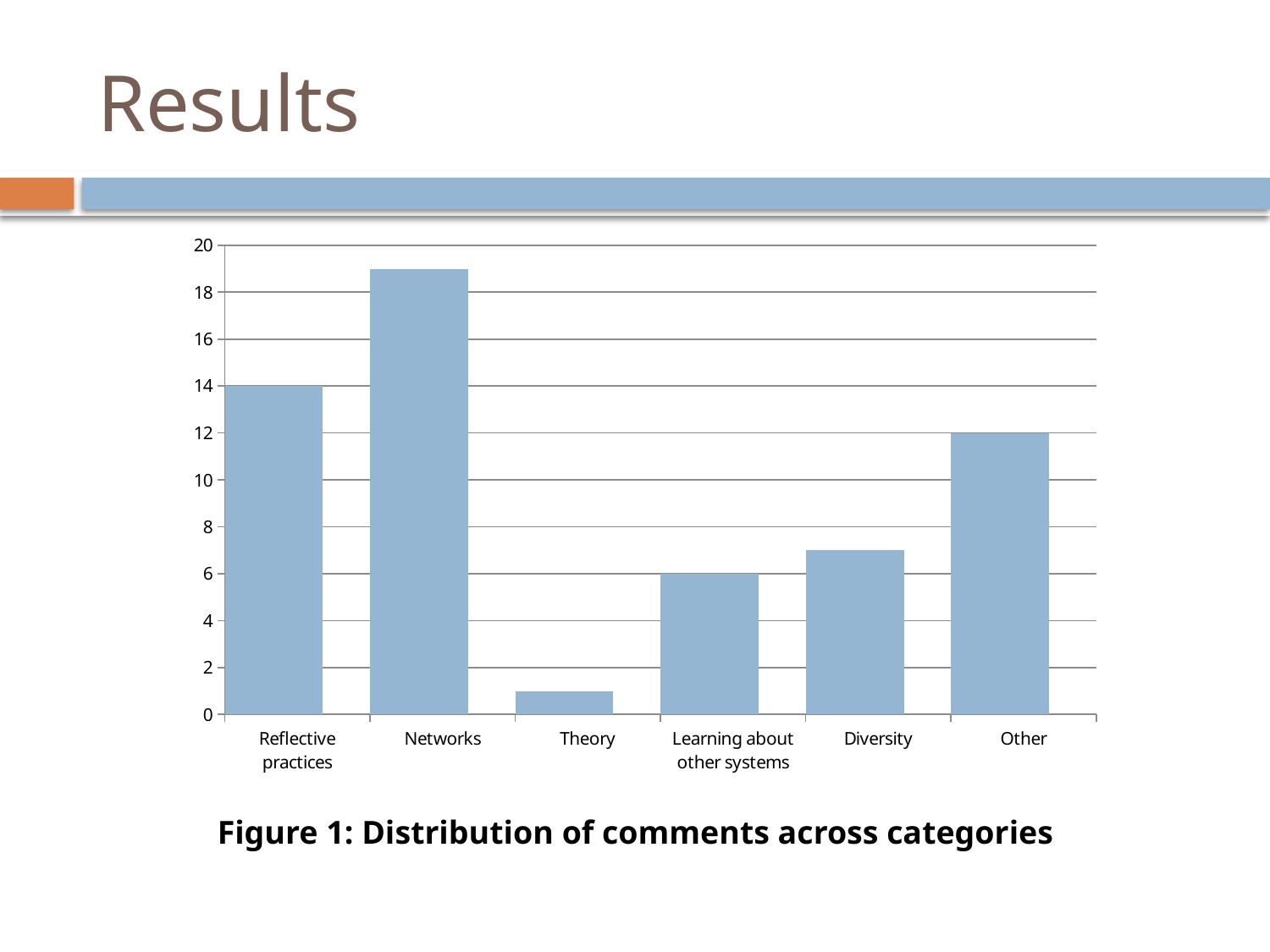
What is the difference between the values for Reflective practices and Other? 2 Is the value for Networks greater or less than 18? greater Which category has the highest value? Networks What is the difference between the values for Other and Learning about other systems? 6 What is the value for Learning about other systems? 6 What is the value for Reflective practices? 14 How many categories are shown on the x axis? 6 Which category has the lowest value? Theory Which is larger, the value for Networks or the value for Reflective practices? Networks Which is larger, the value for Other or the value for Diversity? Other What is the value for Other? 12 Is the value for Theory greater or less than 2? less